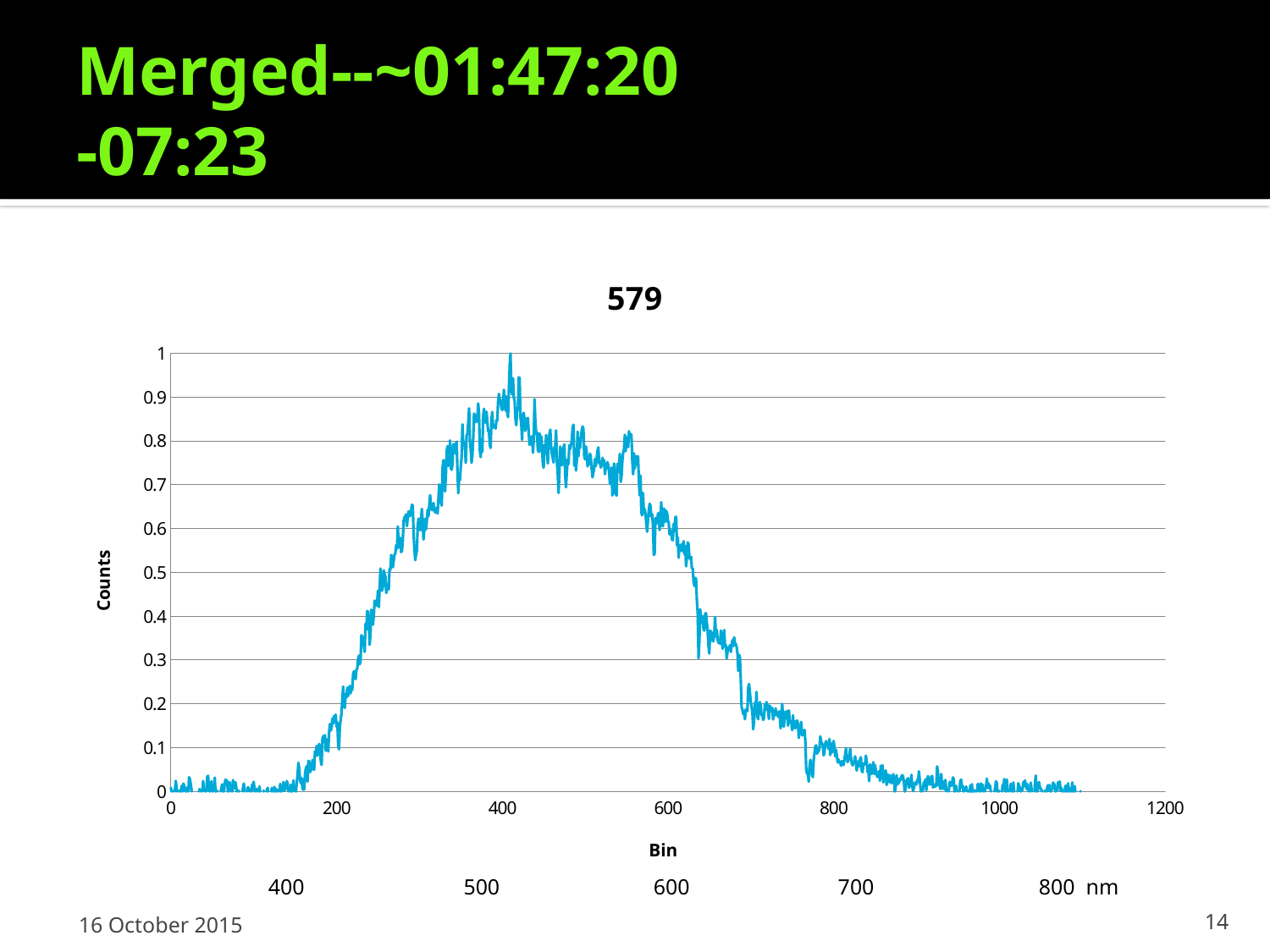
What is the title of the chart? 579 Do the values rise or fall as the bin increases from 200 to 400? rise Is the value at bin 800 greater or less than 0.2? less What is the label of the y axis of the chart? Counts Which has the larger value, bin 400 or bin 800? bin 400 Is the value at bin 400 greater or less than 0.8? greater Is the value at bin 200 greater or less than 0.5? less Do the values rise or fall as the bin increases from 600 to 800? fall What kind of chart is shown on the slide? line chart What is the highest value reached by the line on the chart? 1